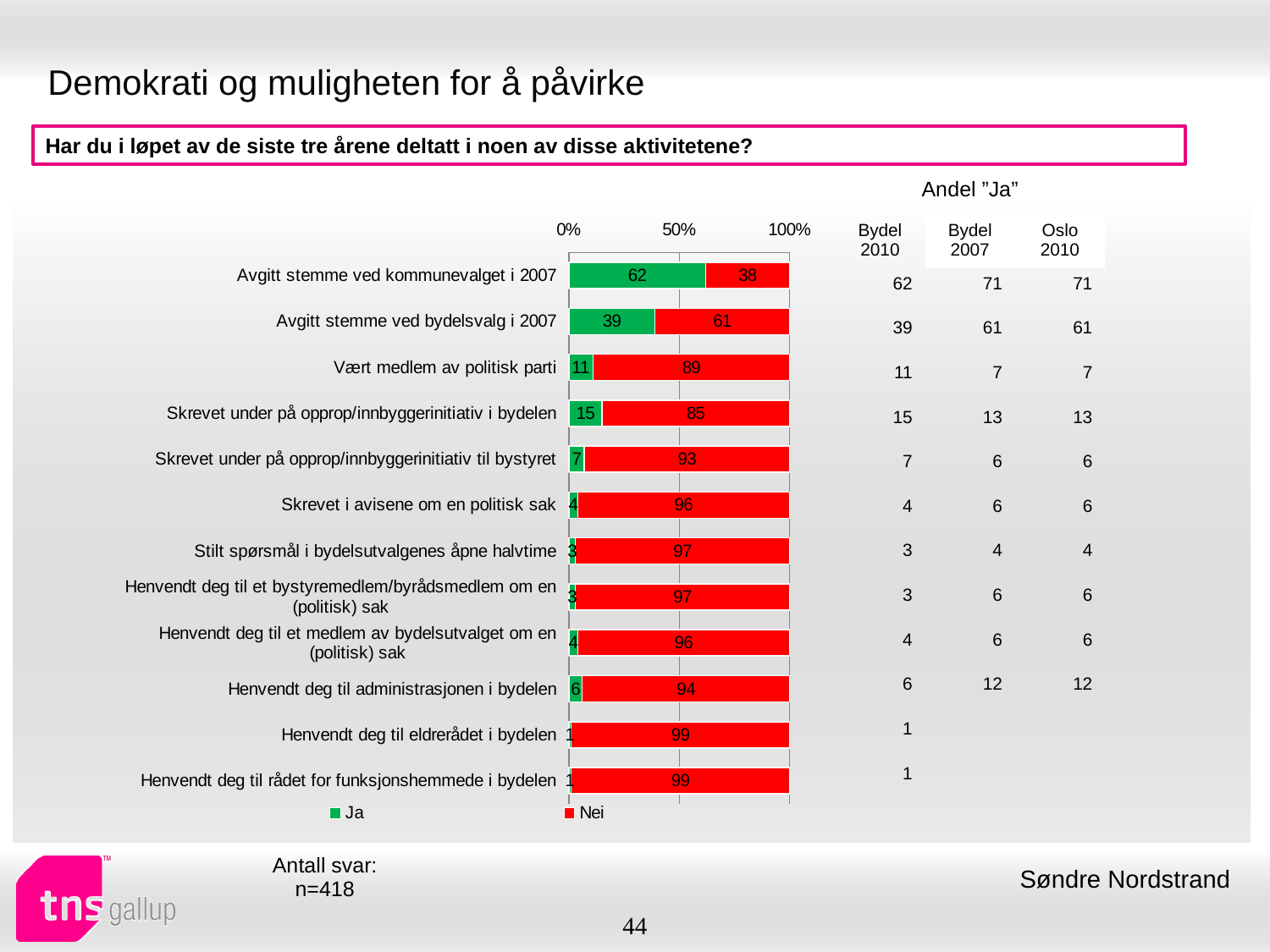
What kind of chart is shown on the slide? Stacked bar chart What are the two series named in the chart legend? Ja and Nei Which is larger: the 'Ja' value for 'Vært medlem av politisk parti' or the 'Ja' value for 'Skrevet under på opprop/innbyggerinitiativ i bydelen'? Skrevet under på opprop/innbyggerinitiativ i bydelen What is the total of the stacked bar for 'Henvendt deg til administrasjonen i bydelen'? 100 What is the 'Ja' value for 'Skrevet under på opprop/innbyggerinitiativ i bydelen'? 15 What is the 'Nei' value for 'Avgitt stemme ved bydelsvalg i 2007'? 61 Which category has the highest 'Ja' value? Avgitt stemme ved kommunevalget i 2007 What is the difference between the 'Ja' values for 'Avgitt stemme ved kommunevalget i 2007' and 'Avgitt stemme ved bydelsvalg i 2007'? 23 How many categories (activities) are plotted in the chart? 12 What is the 'Ja' value for 'Avgitt stemme ved kommunevalget i 2007'? 62 Which category has the highest 'Nei' value? Henvendt deg til eldrerådet i bydelen and Henvendt deg til rådet for funksjonshemmede i bydelen (both 99) How many series does the chart legend list? 2